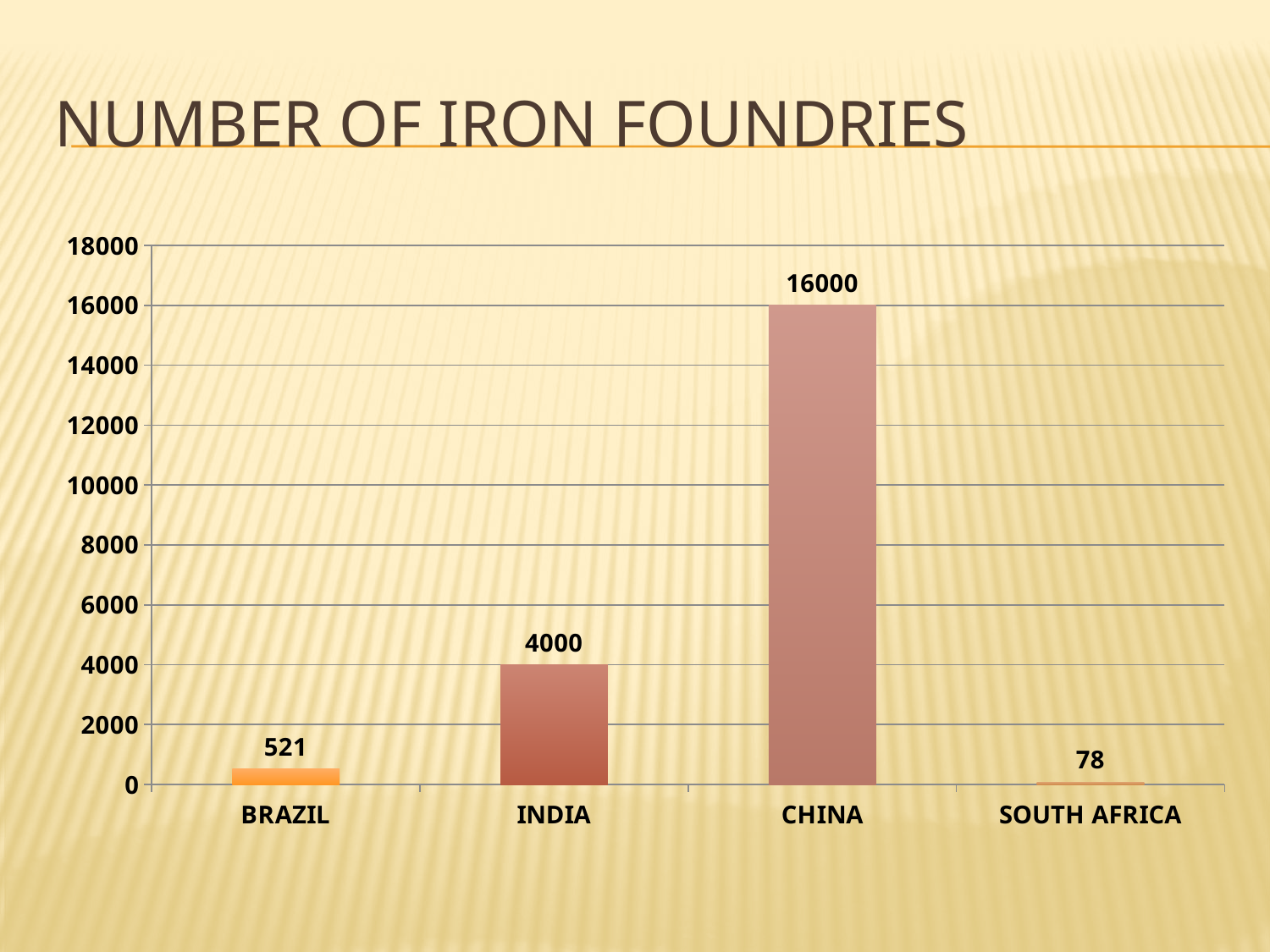
What is the title of the slide? NUMBER OF IRON FOUNDRIES What kind of chart is shown on the slide? Bar chart What is the number of iron foundries for Brazil? 521 Which has more iron foundries, Brazil or India? India Which country has the lowest number of iron foundries? South Africa What is the difference between the number of iron foundries in China and India? 12000 What is the number of iron foundries for South Africa? 78 What is the number of iron foundries for India? 4000 What is the difference between the number of iron foundries in Brazil and South Africa? 443 How many countries are shown in the chart? 4 Which country has the highest number of iron foundries? China What is the number of iron foundries for China? 16000